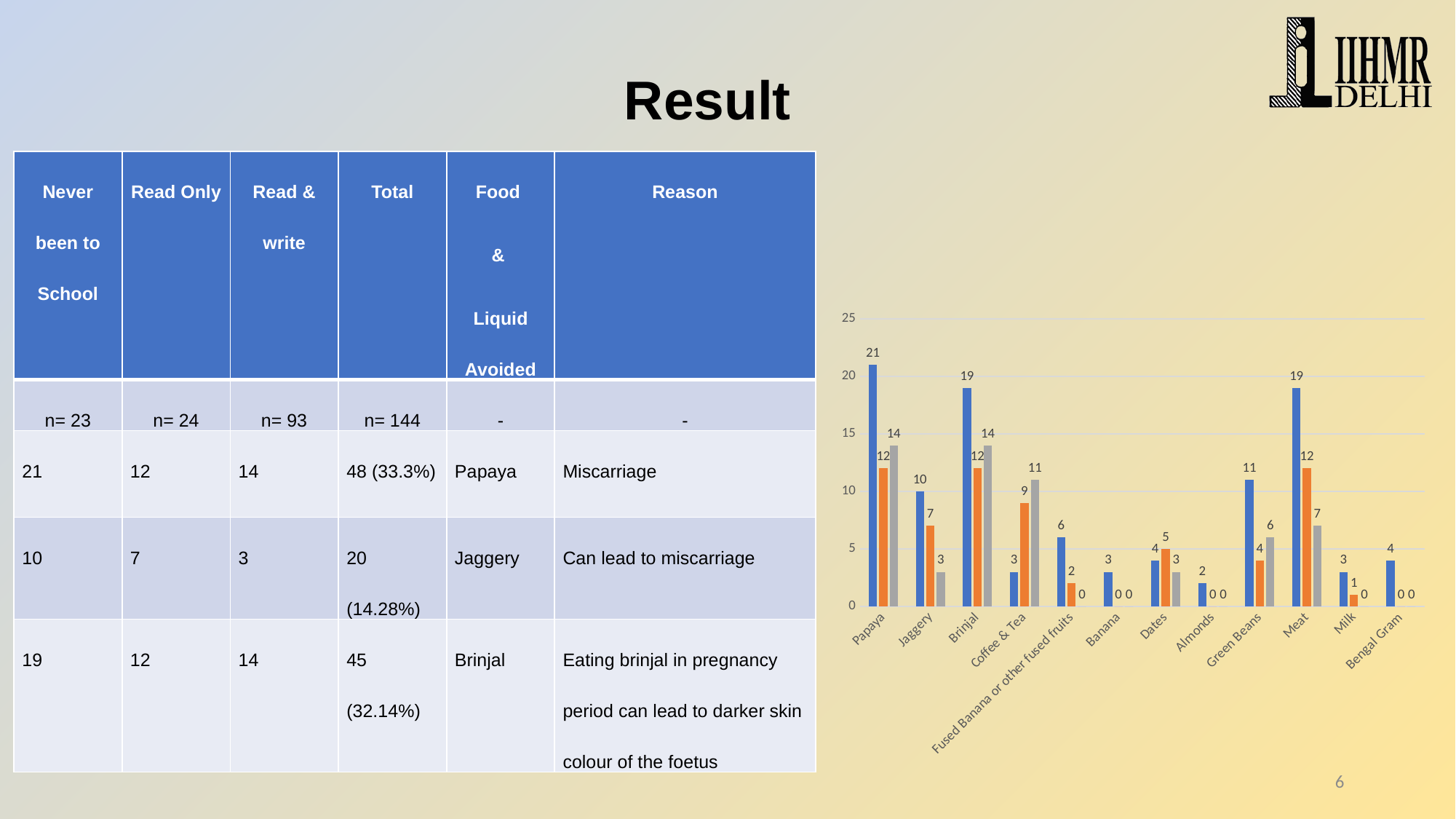
In the bar chart, what is the total of the three bars for Brinjal? 45 In the bar chart, which category has the highest blue bar? Papaya In the bar chart, what is the value of the orange bar for Coffee & Tea? 9 In the bar chart, what is the value of the blue bar for Papaya? 21 In the bar chart, what is the difference between the blue bar for Meat and the orange bar for Meat? 7 What kind of chart is shown on the right side of the slide? bar chart In the bar chart, what is the value of the orange bar for Milk? 1 In the bar chart, what is the value of the grey bar for Green Beans? 6 In the bar chart, which category has the highest grey bar? Papaya and Brinjal (both 14) In the bar chart, which is larger for Coffee & Tea: the blue bar or the grey bar? the grey bar How many food categories are shown on the x axis of the bar chart? 12 What is the highest value shown on the y axis of the bar chart? 25